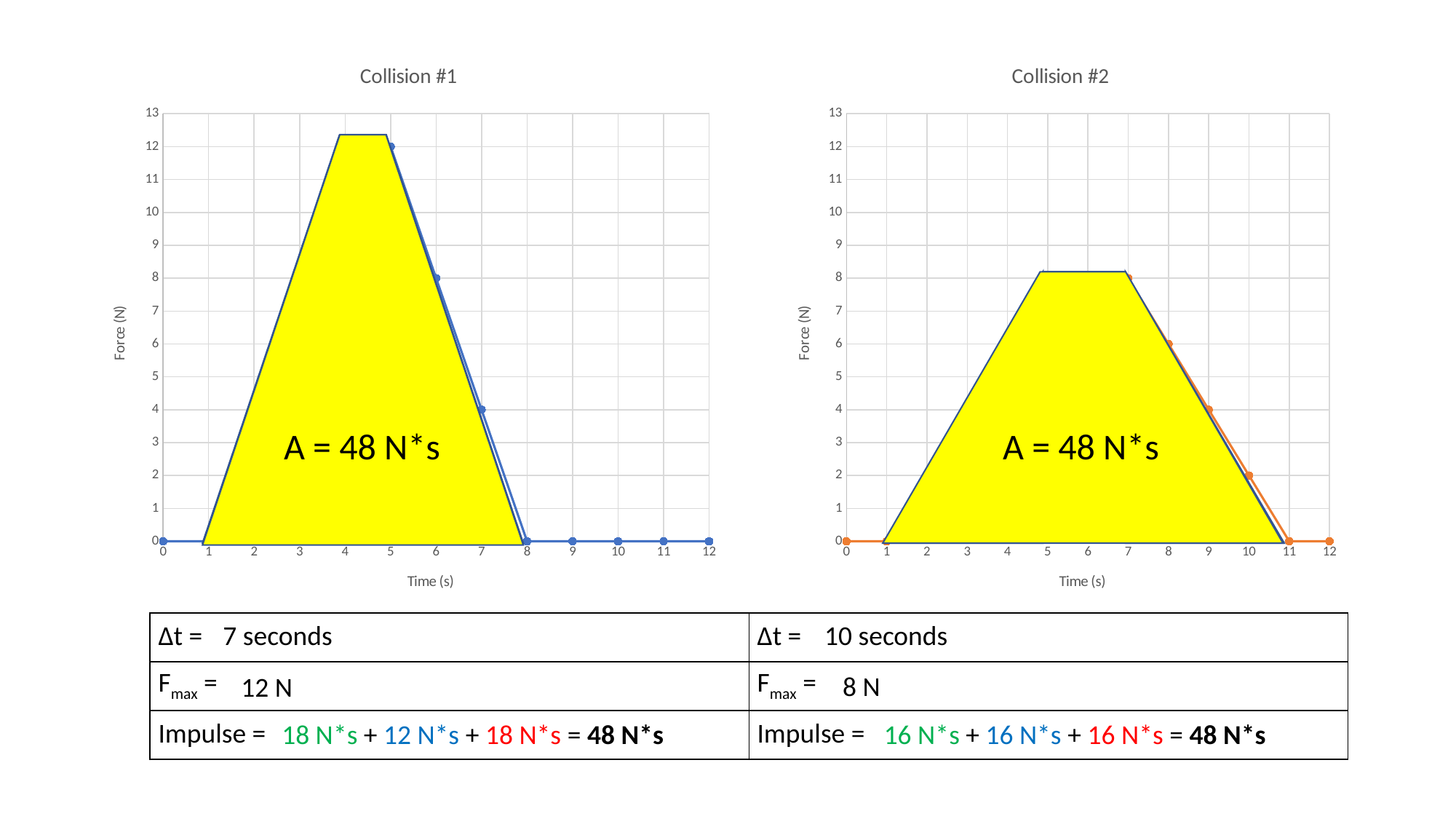
What area label is printed inside the shaded region of the Collision #2 chart? A = 48 N*s Which chart shows the higher peak force, Collision #1 or Collision #2? Collision #1 In the Collision #2 chart, is the force at 8 s greater or less than 5? greater In the Collision #1 chart, at what time does the force first return to 0 after the peak? 8 In the Collision #1 chart, what is the force at 5 s? 12 In the Collision #1 chart, what is the force at 6 s? 8 In the Collision #1 chart, what is the force at 7 s? 4 In the Collision #2 chart, what is the force at 9 s? 4 In the Collision #2 chart, does the force rise or fall between 7 s and 11 s? fall In the Collision #2 chart, what is the force at 10 s? 2 What is the difference between the peak force in Collision #1 and the peak force in Collision #2? 4 N What kind of chart is the Collision #1 chart? line chart